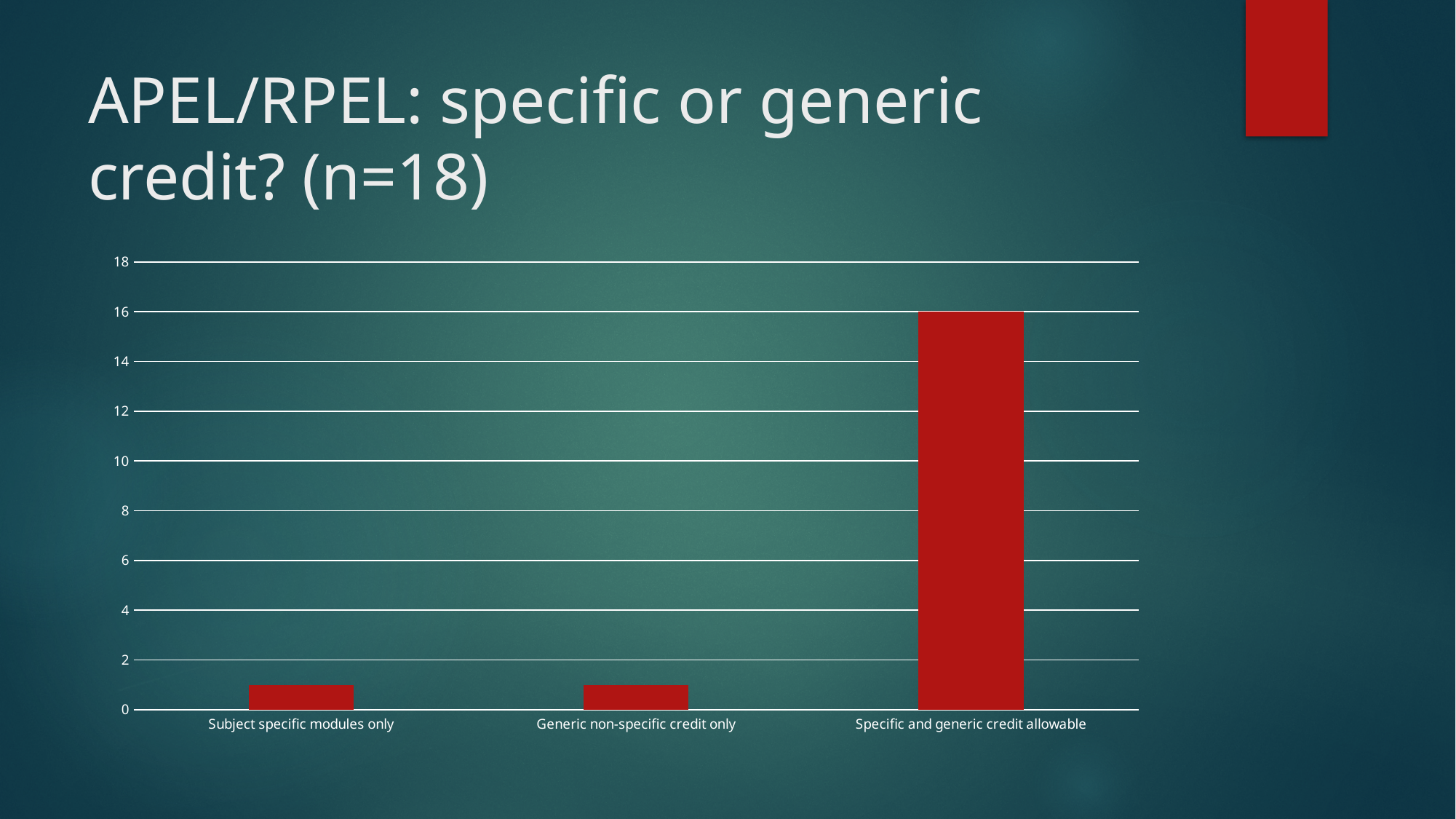
Which category has the highest value in the chart? Specific and generic credit allowable What is the title of the slide containing the chart? APEL/RPEL: specific or generic credit? (n=18) Is the value for Generic non-specific credit only greater or less than 2? less Is the value for Subject specific modules only greater or less than 2? less How many categories are shown on the x axis of the chart? 3 Which is larger, the value for Subject specific modules only or the value for Specific and generic credit allowable? Specific and generic credit allowable Which is larger, the value for Generic non-specific credit only or the value for Specific and generic credit allowable? Specific and generic credit allowable What is the highest value shown on the y axis of the chart? 18 Is the value for Specific and generic credit allowable greater or less than 10? greater What type of chart is shown on the slide? bar chart What is the value for Specific and generic credit allowable? 16